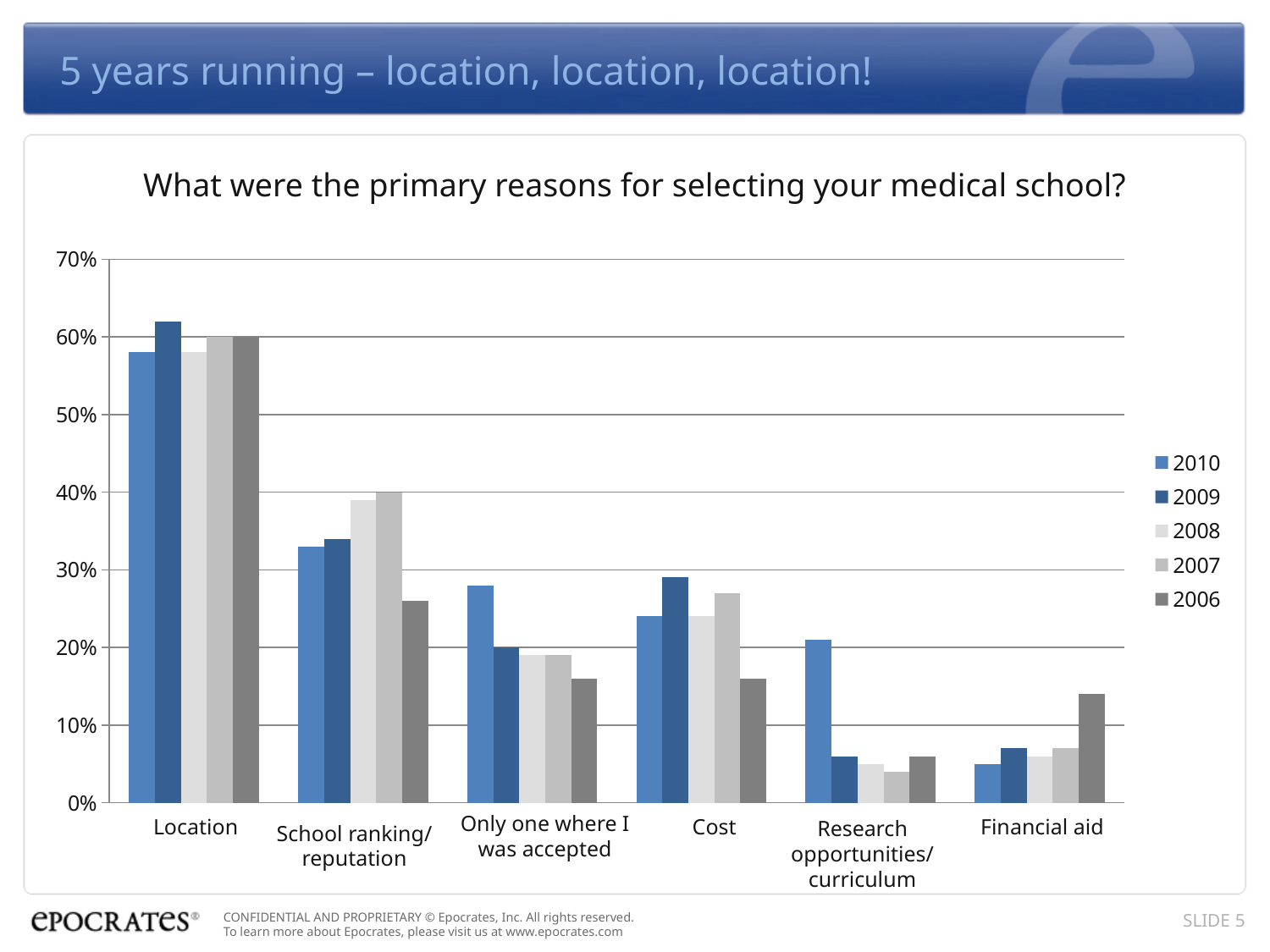
Is the 2010 value for Location greater or less than 50%? greater Which category has the lowest value for the 2010 series? Financial aid For Location, which is larger: the 2009 value or the 2010 value? 2009 Is the 2009 value for Cost greater or less than 20%? greater Is the 2008 value for Research opportunities/curriculum greater or less than 10%? less How many categories are shown on the x axis? 6 How many series does the legend list? 5 Do the 2010 values rise or fall moving from Location to Financial aid along the x axis? fall What kind of chart is shown on the slide? bar chart For Research opportunities/curriculum, which is larger: the 2010 value or the 2009 value? 2010 Which category has the highest value for the 2010 series? Location